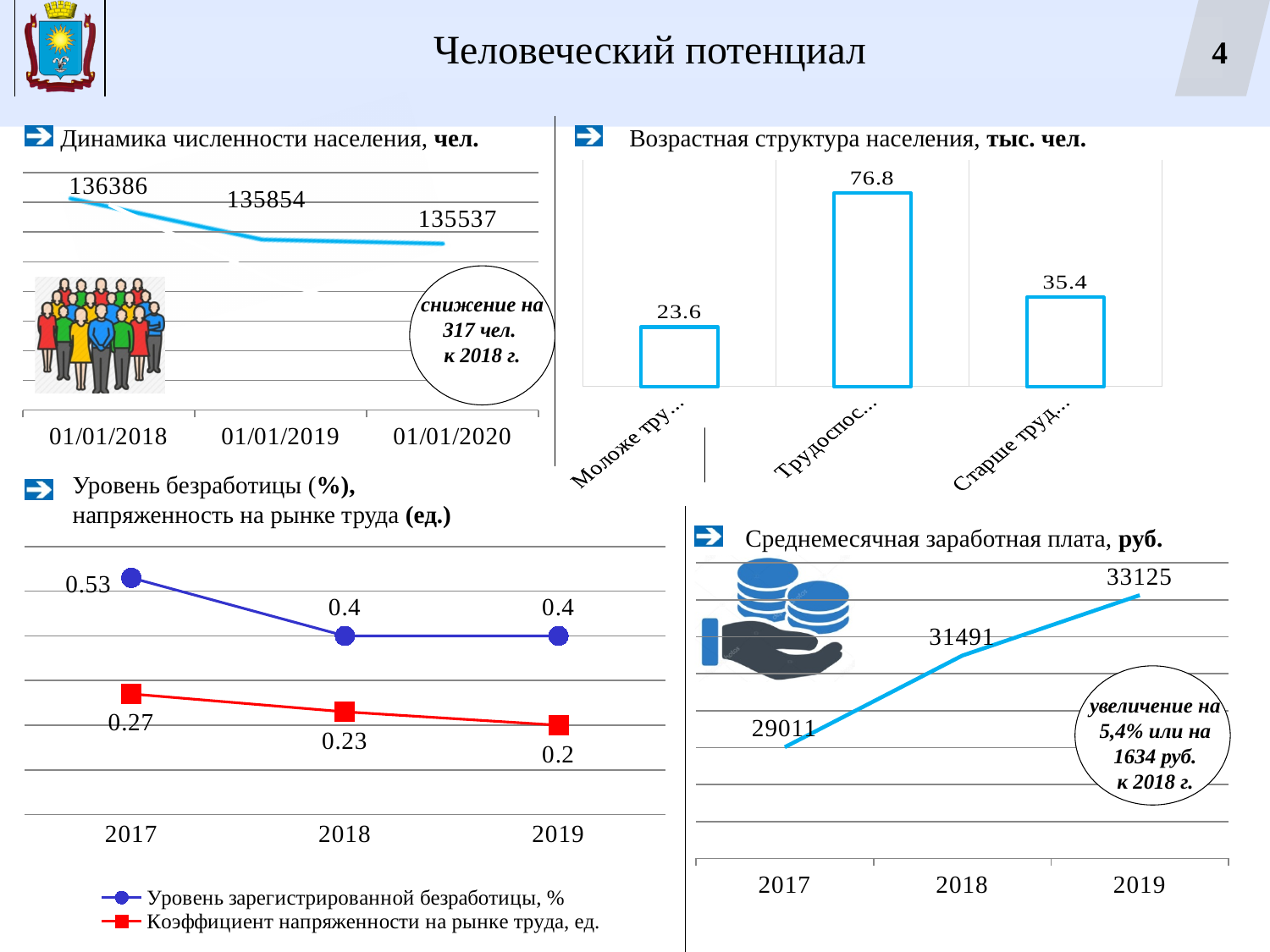
In the chart 'Возрастная структура населения, тыс. чел.', which bar is the lowest? the first (leftmost) bar, 23.6 In the chart 'Динамика численности населения, чел.', what is the population value for 01/01/2018? 136386 In the chart 'Среднемесячная заработная плата, руб.', which year has the highest value? 2019 In the chart 'Уровень безработицы (%), напряженность на рынке труда (ед.)', what is the value of 'Коэффициент напряженности на рынке труда, ед.' for 2019? 0.2 In the chart 'Уровень безработицы (%), напряженность на рынке труда (ед.)', what is the value of 'Уровень зарегистрированной безработицы, %' for 2017? 0.53 What type of chart is 'Возрастная структура населения, тыс. чел.'? bar chart In the chart 'Среднемесячная заработная плата, руб.', what is the value for 2018? 31491 In the chart 'Возрастная структура населения, тыс. чел.', how many bars are plotted? 3 In the chart 'Динамика численности населения, чел.', what is the difference between the values for 01/01/2018 and 01/01/2020? 849 How many series does the legend of the chart 'Уровень безработицы (%), напряженность на рынке труда (ед.)' list? 2 In the chart 'Возрастная структура населения, тыс. чел.', what is the value of the middle bar? 76.8 In the chart 'Динамика численности населения, чел.', do the values rise or fall from 01/01/2018 to 01/01/2020? fall